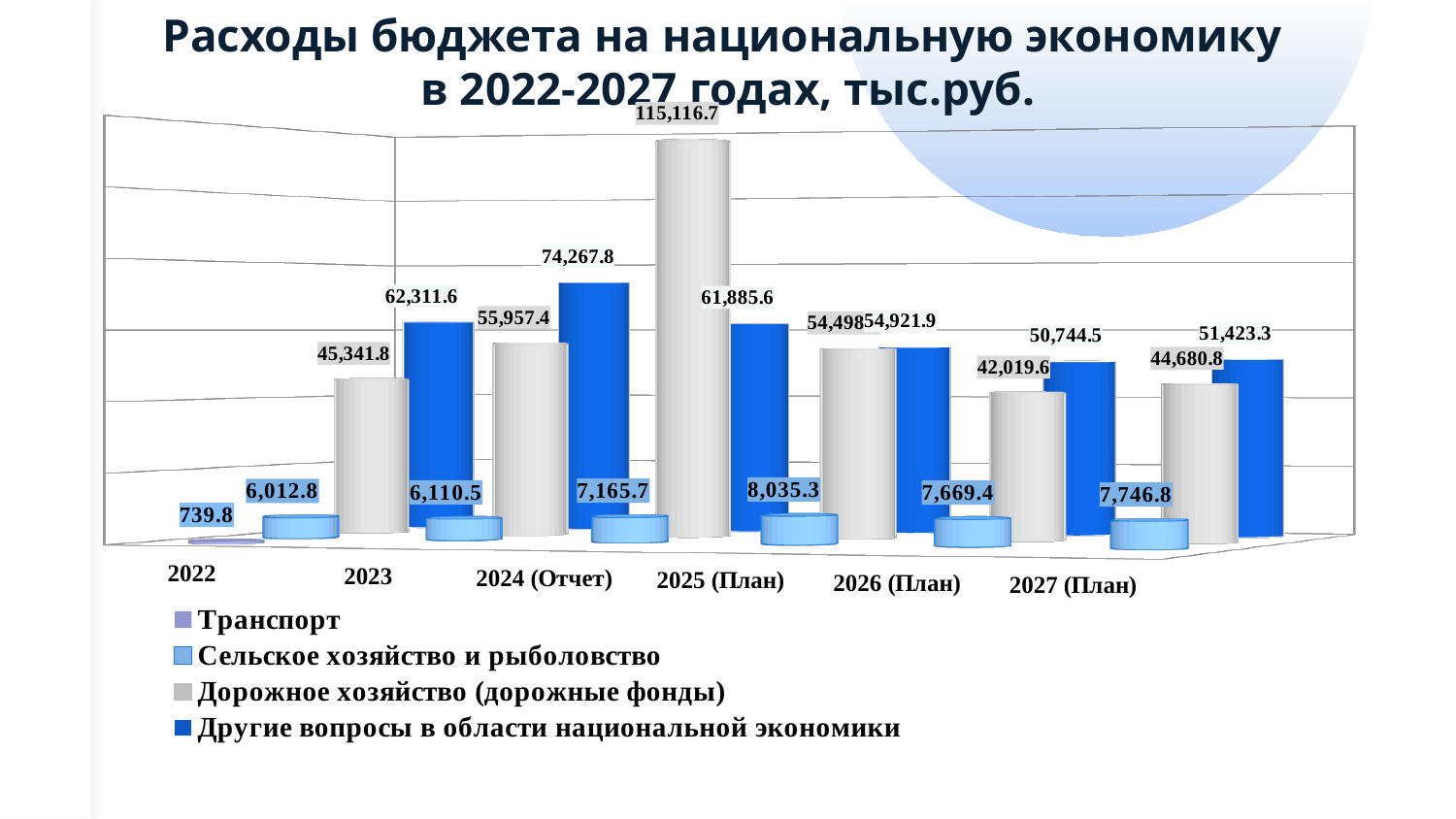
Does the value for Сельское хозяйство и рыболовство rise or fall from 2022 to 2025 (План)? Rise How many series does the legend list? 4 What is the value for Сельское хозяйство и рыболовство in 2025 (План)? 8,035.3 In which year is the value for Сельское хозяйство и рыболовство the lowest? 2022 In which year is the value for Дорожное хозяйство (дорожные фонды) the highest? 2024 (Отчет) How many year categories are shown on the x axis? 6 In 2026 (План), which is larger: Дорожное хозяйство (дорожные фонды) or Другие вопросы в области национальной экономики? Другие вопросы в области национальной экономики What is the value for Транспорт in 2022? 739.8 What is the difference between the values for Другие вопросы в области национальной экономики in 2023 and 2022? 11,956.2 In which year is the value for Другие вопросы в области национальной экономики the highest? 2023 What kind of chart is shown on the slide? Bar chart What is the value for Дорожное хозяйство (дорожные фонды) in 2024 (Отчет)? 115,116.7